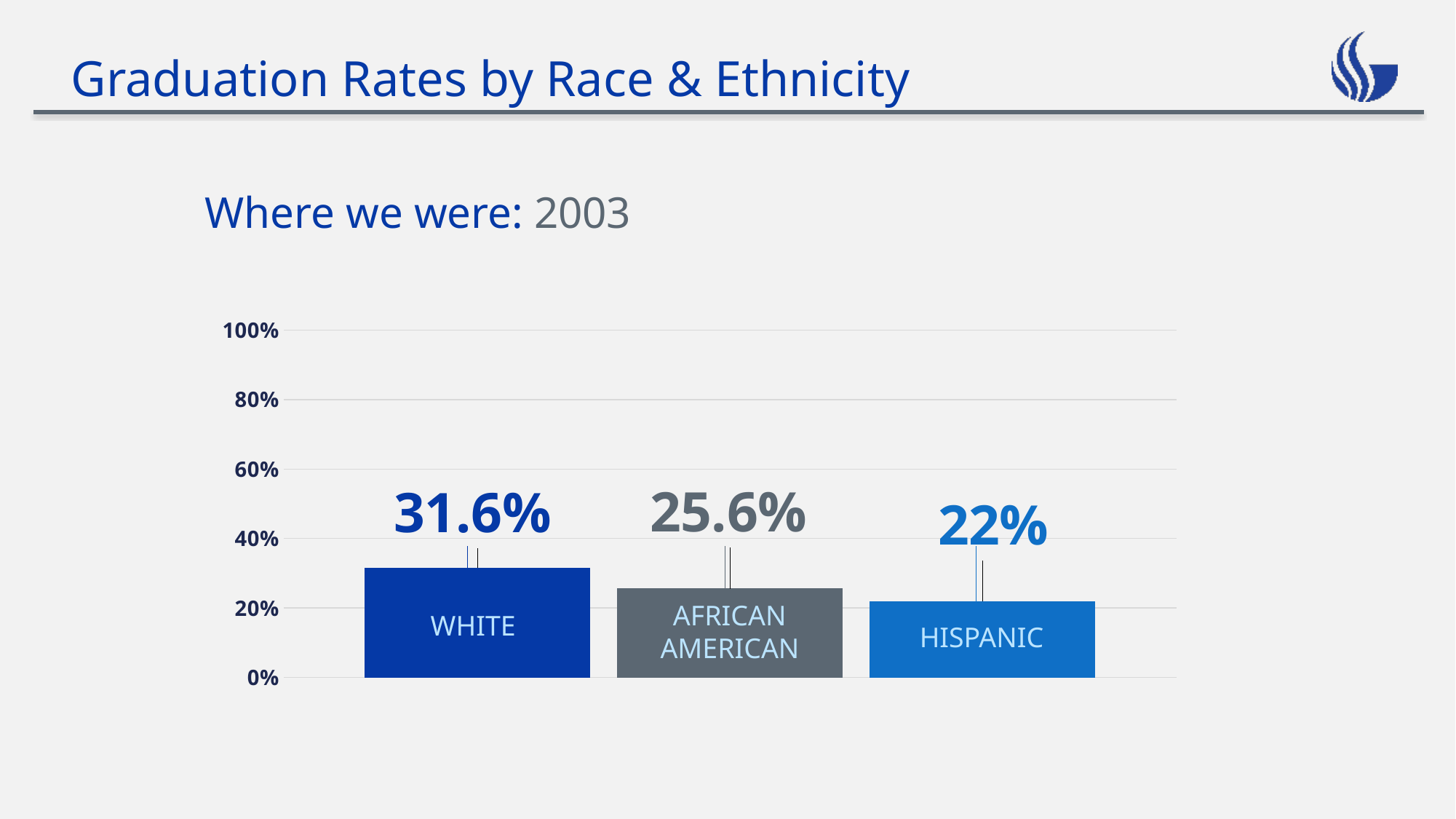
What is the difference between the White and African American graduation rates? 6% What is the graduation rate for African American students in 2003? 25.6% What is the difference between the White and Hispanic graduation rates? 9.6% Which is larger, the graduation rate for African American students or for Hispanic students? African American What is the graduation rate for Hispanic students in 2003? 22% Which group has the lowest graduation rate? Hispanic What is the graduation rate for White students in 2003? 31.6% What year does the chart's data refer to? 2003 Which group has the highest graduation rate? White How many groups are shown in the chart? 3 What kind of chart is shown on the slide? Bar chart Is the graduation rate for White students greater or less than 40%? less